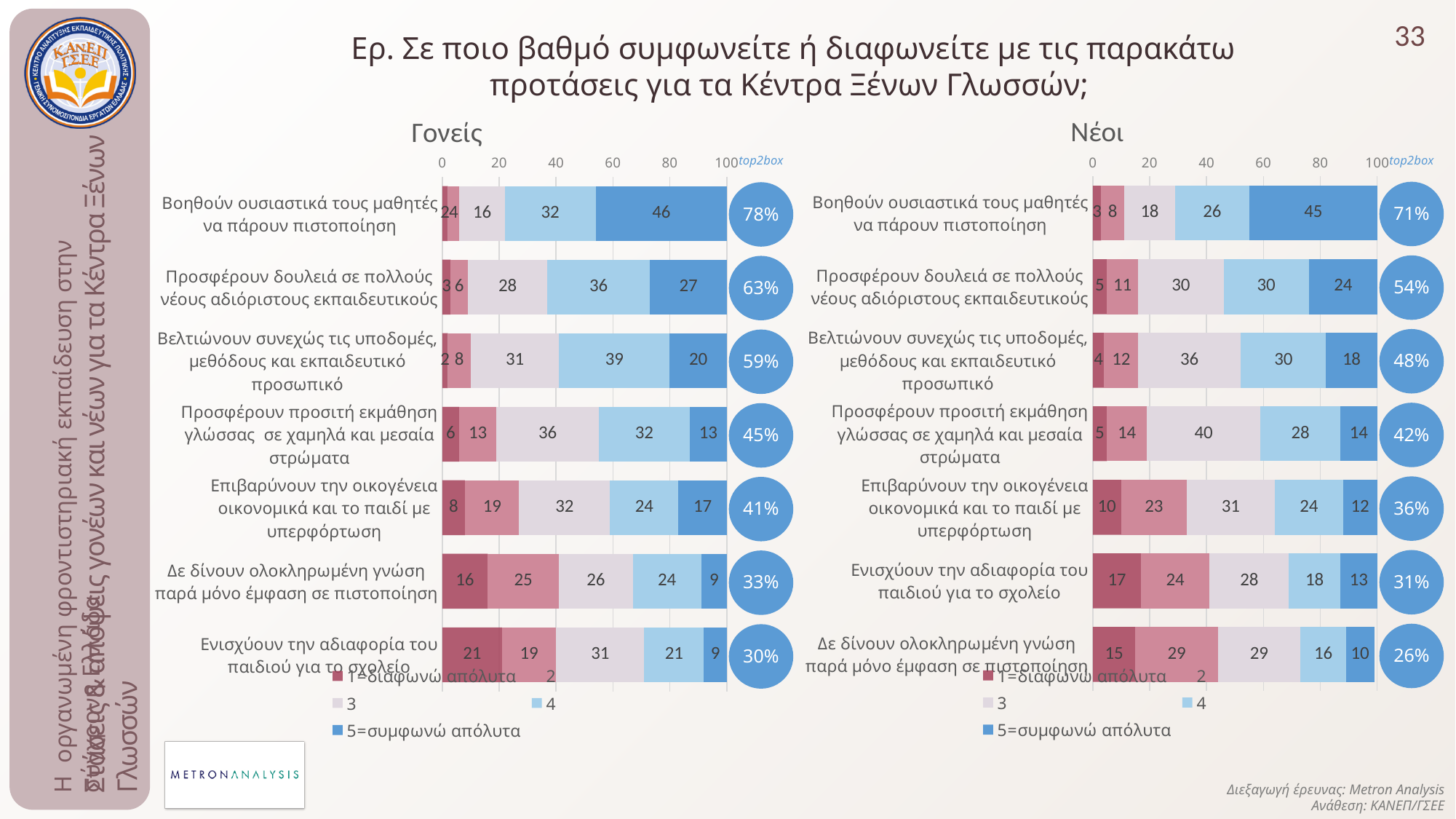
Which chart shows a higher '1=διαφωνώ απόλυτα' value for 'Επιβαρύνουν την οικογένεια οικονομικά και το παιδί με υπερφόρτωση', Γονείς or Νέοι? Νέοι How many statements (categories) are shown in the Γονείς chart? 7 What type of chart is the Γονείς chart? Stacked bar chart In the Γονείς chart, what is the total of the '4' and '5=συμφωνώ απόλυτα' segments for 'Βελτιώνουν συνεχώς τις υποδομές, μεθόδους και εκπαιδευτικό προσωπικό'? 59 In the Γονείς chart, what is the top2box percentage for 'Προσφέρουν δουλειά σε πολλούς νέους αδιόριστους εκπαιδευτικούς'? 63% In the Νέοι chart, what is the difference between the '5=συμφωνώ απόλυτα' values for 'Βοηθούν ουσιαστικά τους μαθητές να πάρουν πιστοποίηση' and 'Προσφέρουν δουλειά σε πολλούς νέους αδιόριστους εκπαιδευτικούς'? 21 In the Γονείς chart, which statement has the lowest top2box percentage? Ενισχύουν την αδιαφορία του παιδιού για το σχολείο In the Νέοι chart, which statement has the highest top2box percentage? Βοηθούν ουσιαστικά τους μαθητές να πάρουν πιστοποίηση How many series does the legend of the Νέοι chart list? 5 In the Γονείς chart, what is the value of the '5=συμφωνώ απόλυτα' segment for 'Βοηθούν ουσιαστικά τους μαθητές να πάρουν πιστοποίηση'? 46 What label does the legend give to the darkest blue series in both charts? 5=συμφωνώ απόλυτα In the Νέοι chart, what is the value of the '3' segment for 'Προσφέρουν προσιτή εκμάθηση γλώσσας σε χαμηλά και μεσαία στρώματα'? 40